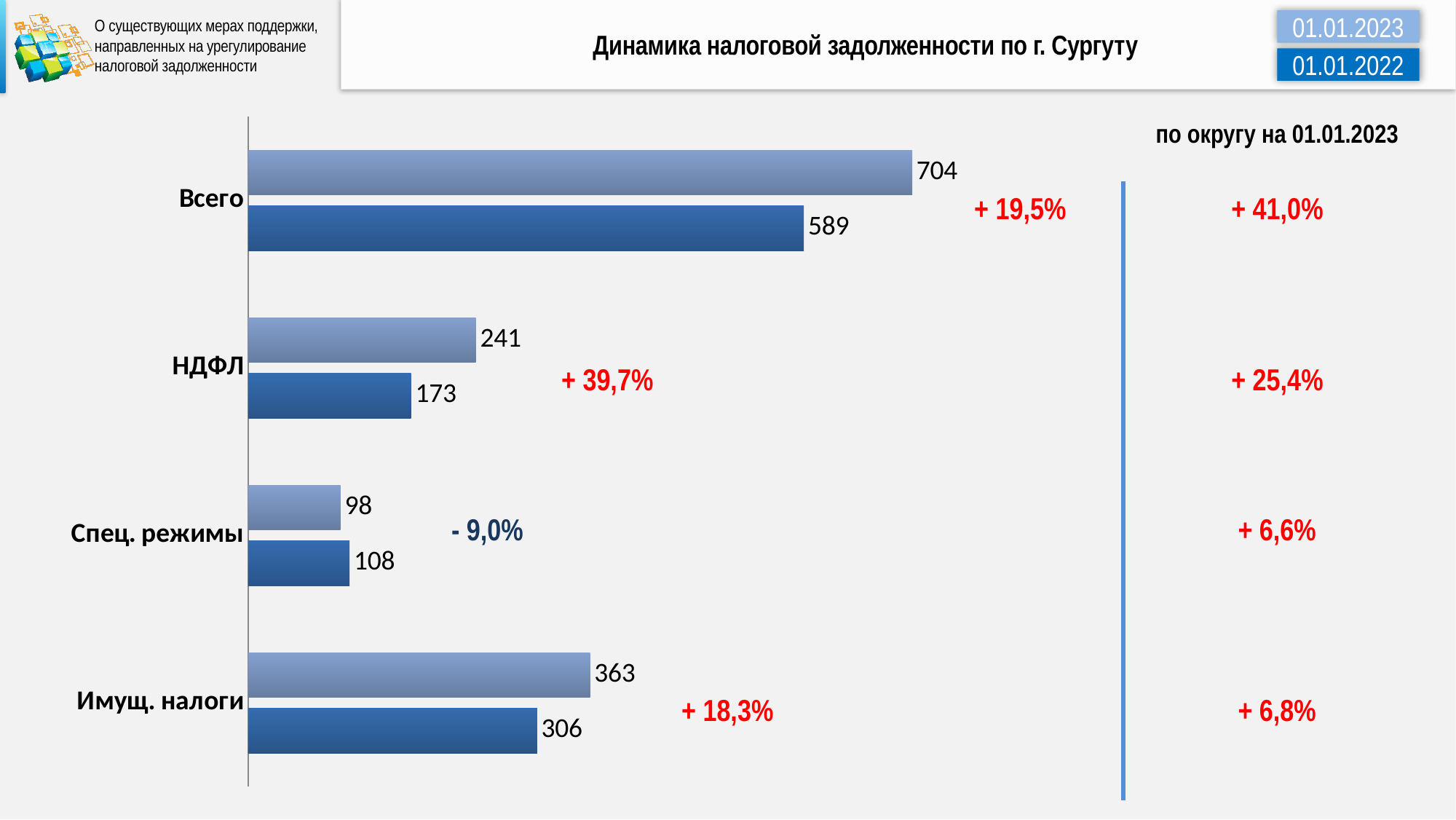
Which category has the lowest value on 01.01.2023? Спец. режимы Which category has the highest value on 01.01.2022? Всего What is the value for Спец. режимы on 01.01.2023? 98 What is the difference between the 01.01.2023 and 01.01.2022 values for Имущ. налоги? 57 What is the value for НДФЛ on 01.01.2022? 173 What is the difference between the 01.01.2023 and 01.01.2022 values for Всего? 115 What is the value for Всего on 01.01.2023? 704 How many categories are shown on the chart? 4 How many series does the legend list? 2 What kind of chart is shown on the slide? Bar chart What is the value for Имущ. налоги on 01.01.2022? 306 Which is larger for Спец. режимы: the 01.01.2023 value or the 01.01.2022 value? 01.01.2022